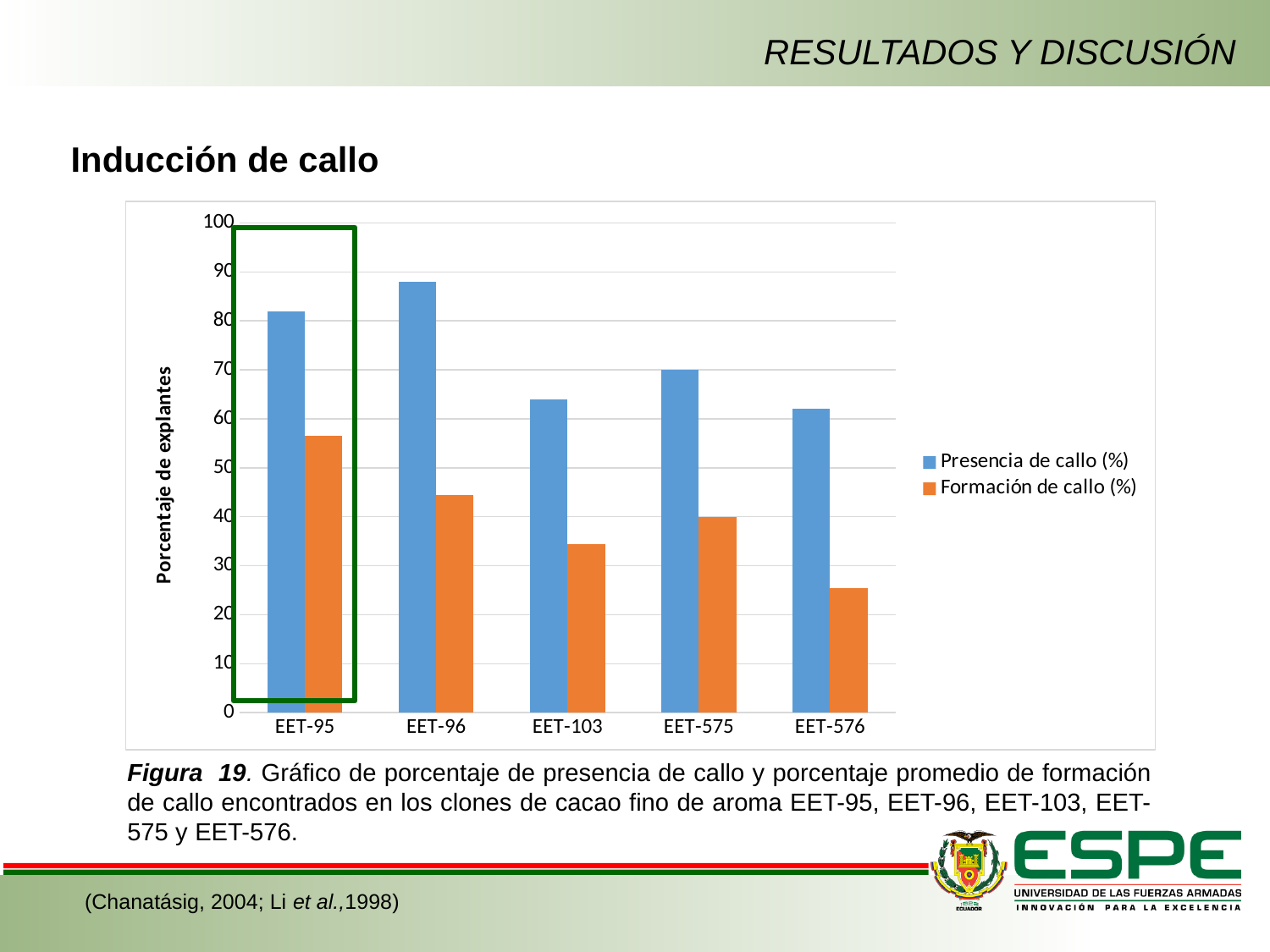
Which clone has the lowest value for Formación de callo (%)? EET-576 How many series does the chart legend list? 2 Is the Formación de callo (%) value for EET-95 greater or less than 50? greater Does the Presencia de callo (%) value rise or fall from EET-96 to EET-103? fall What is the label of the y axis of the chart? Porcentaje de explantes Is the Presencia de callo (%) value for EET-96 greater or less than 80? greater Which clone has the highest value for Formación de callo (%)? EET-95 Is the Formación de callo (%) value for EET-576 greater or less than 30? less What kind of chart is shown on the slide? bar chart Which clone has the highest value for Presencia de callo (%)? EET-96 Which is larger: the Presencia de callo (%) value for EET-95 or for EET-96? EET-96 How many clones (categories) are shown on the x axis of the chart? 5